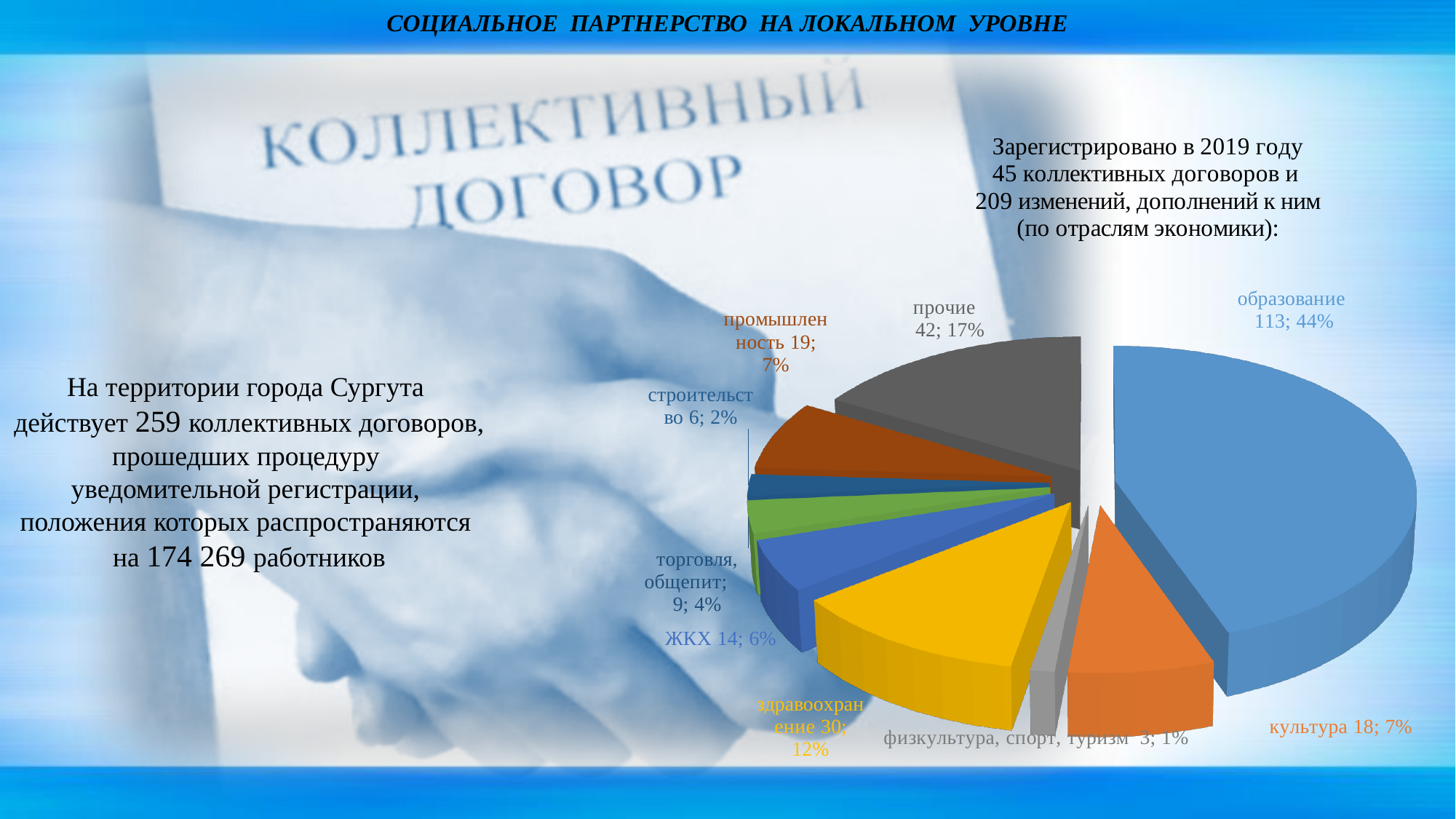
Which category has the smallest slice in the pie chart? физкультура, спорт, туризм What share of the pie does здравоохранение have? 12% Which is larger: the value for ЖКХ or the value for торговля, общепит? ЖКХ What value is shown for прочие in the pie chart? 42 What share of the pie does строительство have? 2% What is the difference between the values for здравоохранение and культура? 12 How many categories (slices) does the pie chart show? 9 What value is shown for образование in the pie chart? 113 What is the difference between the values for образование and прочие? 71 What value is shown for промышленность in the pie chart? 19 Which category has the largest slice in the pie chart? образование What kind of chart is shown on the slide? pie chart